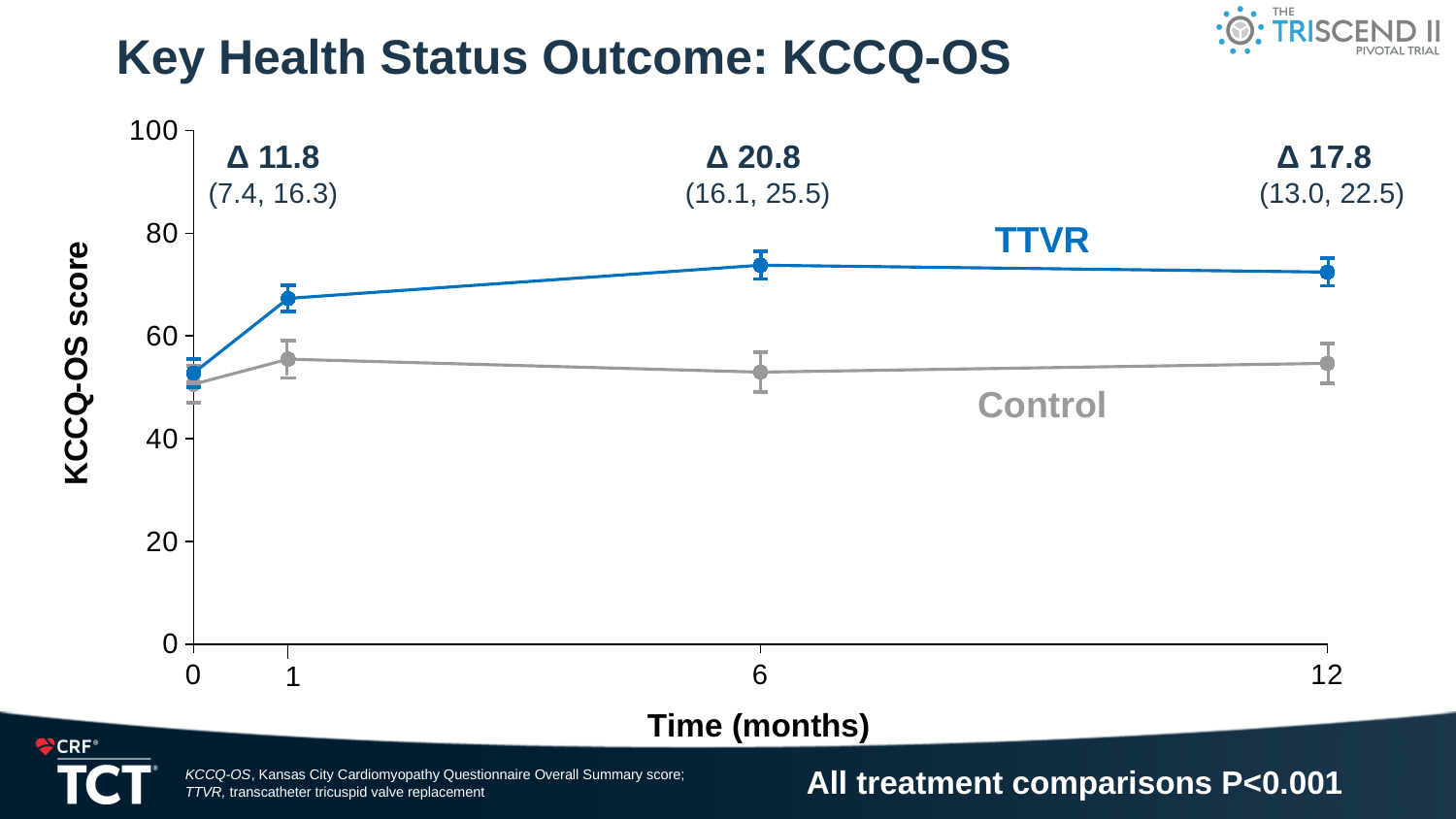
What is the difference (Δ) between TTVR and Control shown at 6 months? 20.8 Is the Control KCCQ-OS score at 6 months greater or less than 60? less Is the TTVR KCCQ-OS score at 6 months greater or less than 60? greater At which time point is the printed Δ between TTVR and Control the largest? 6 months Does the TTVR KCCQ-OS score rise or fall from 0 to 6 months? rise At which time point is the printed Δ between TTVR and Control the smallest? 1 month What is the difference (Δ) between TTVR and Control shown at 12 months? 17.8 How many time points are plotted along the x axis? 4 What is the confidence interval printed under the Δ 11.8 annotation at 1 month? (7.4, 16.3) At 12 months, which group has the higher KCCQ-OS score, TTVR or Control? TTVR What kind of chart is shown on the slide? line chart How many series are plotted on the chart? 2